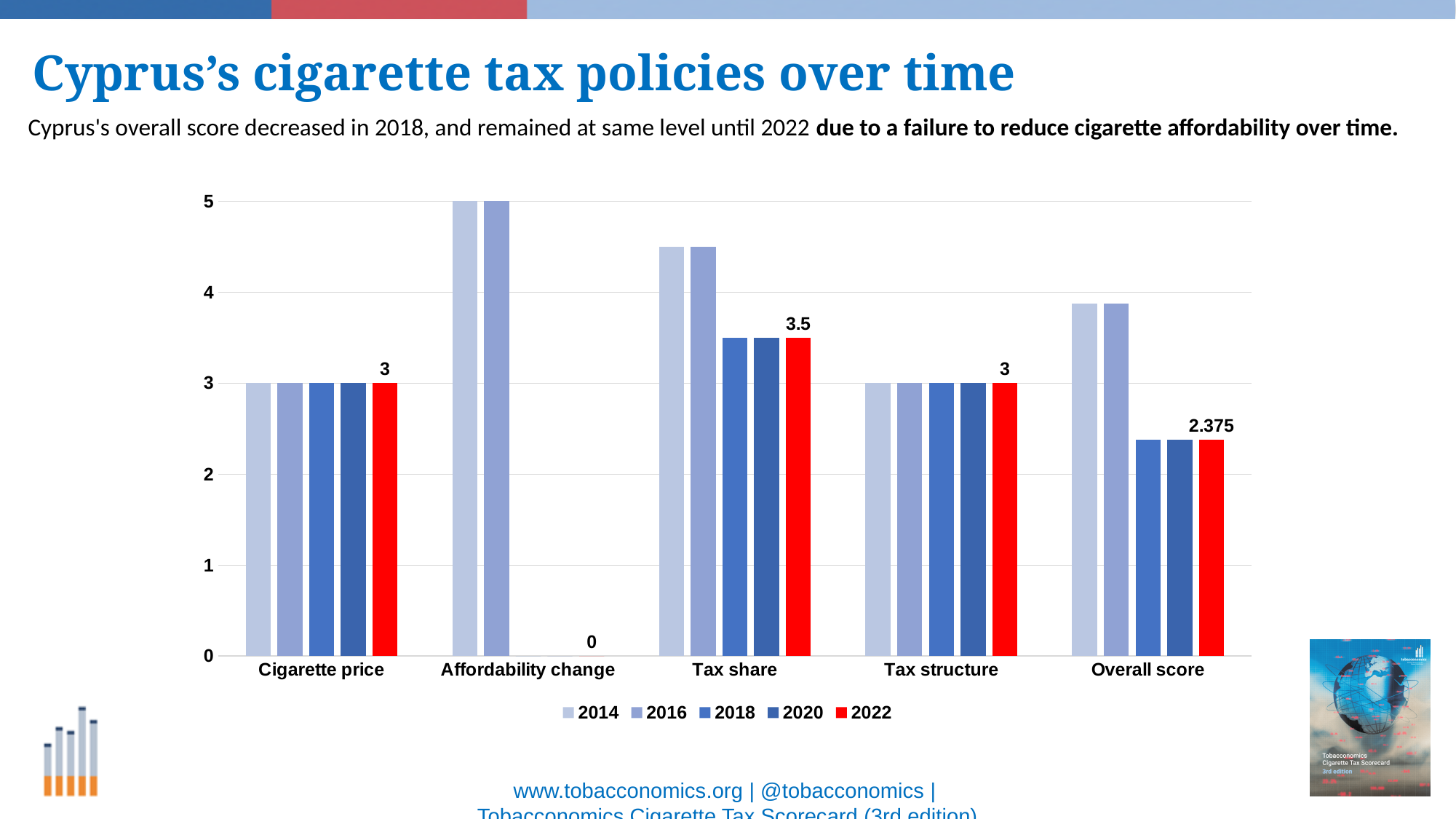
Which is larger in 2022: Tax share or Tax structure? Tax share Is the Overall score for 2014 greater or less than 3? greater What is the difference between the 2022 Tax share value and the 2022 Overall score? 1.125 What is the value for Affordability change in 2014? 5 What is the value for Tax share in 2022? 3.5 How many categories are shown on the x axis? 5 Which category has the lowest value for 2022? Affordability change Which category has the highest value for 2022? Tax share How many series does the legend list? 5 What kind of chart is shown on the slide? bar chart What is the Overall score for 2022? 2.375 What is the value for Affordability change in 2022? 0